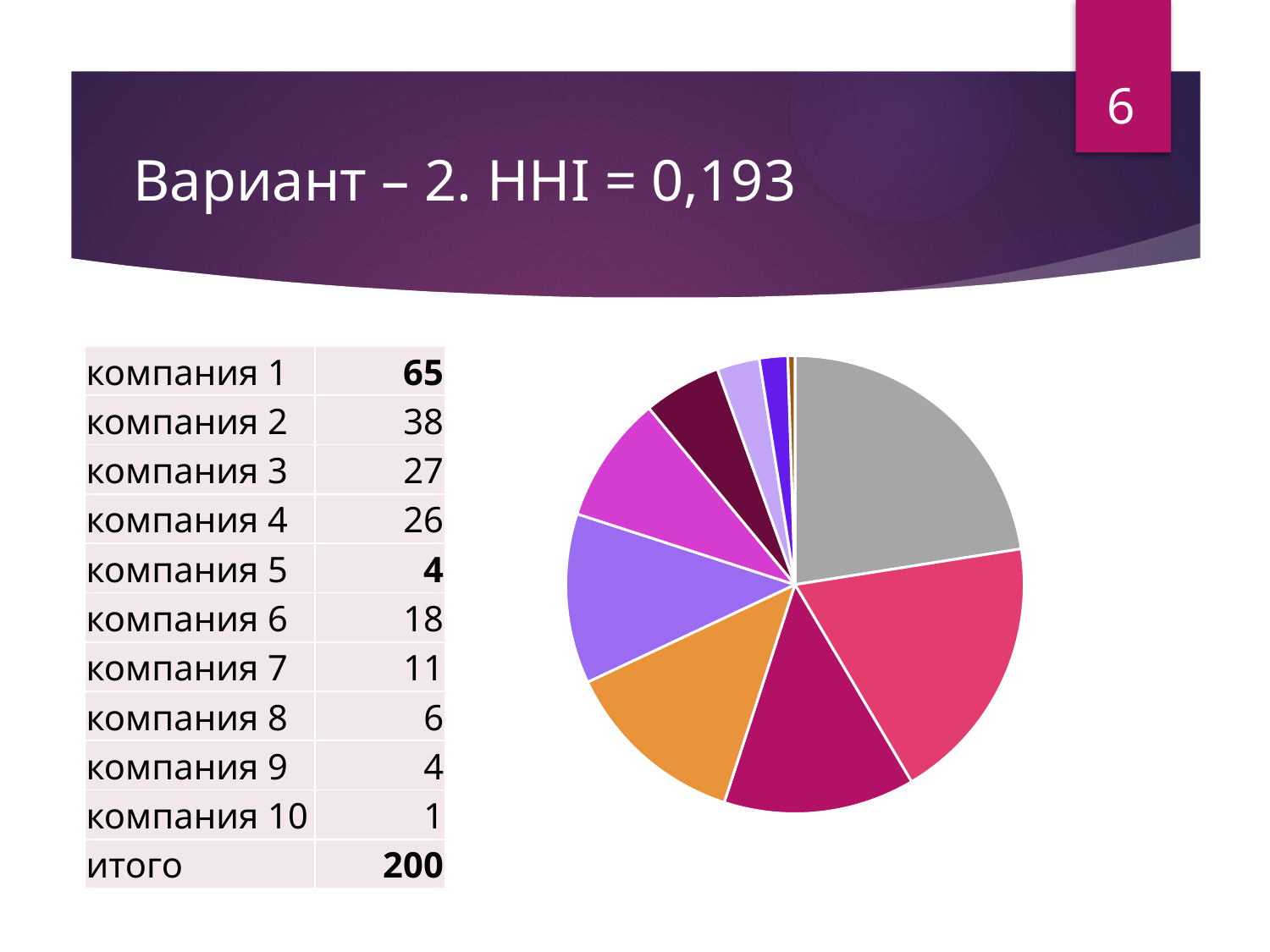
What is the difference between the values for компания 1 and компания 2? 27 What is the value for компания 6? 18 How many slices does the pie chart have? 10 Which company has the lowest value? компания 10 What is the total (итого) of all company values? 200 What colour is the largest slice of the pie chart? gray What kind of chart is shown on the slide? pie chart Which company has the highest value? компания 1 What HHI value is given in the slide title? 0,193 What is the value for компания 10? 1 What is the value for компания 1 in the table next to the pie chart? 65 Which is larger, the value for компания 3 or компания 4? компания 3